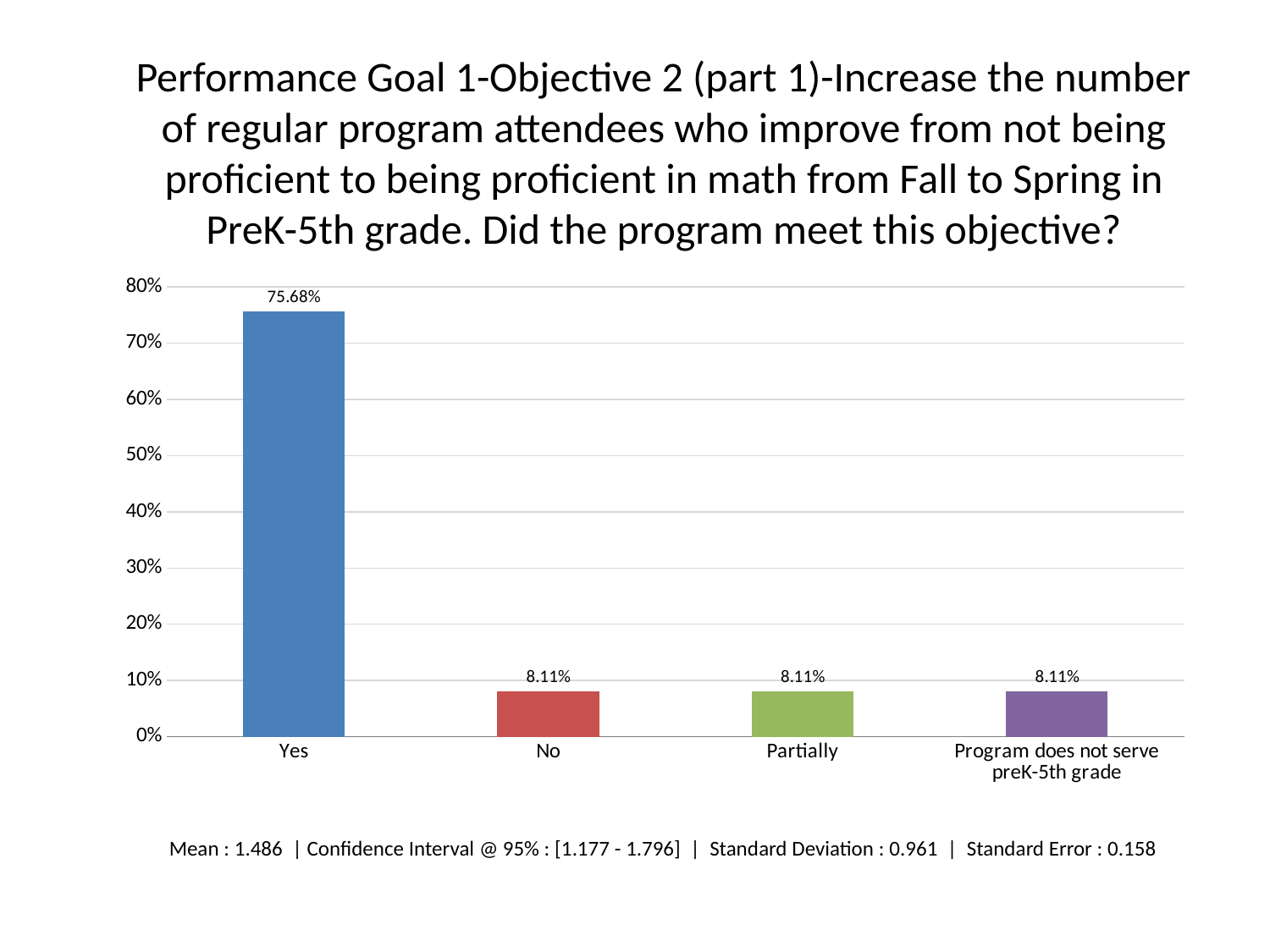
Which is larger, the value for Yes or the value for Partially? Yes Which category has the highest value? Yes What is the value for No? 8.11% What is the value for Yes? 75.68% What is the value for Partially? 8.11% Is the value for Yes greater or less than 70%? greater What is the value for 'Program does not serve preK-5th grade'? 8.11% What is the difference between the values for Yes and No? 67.57% What kind of chart is shown on the slide? bar chart How many categories are shown on the x axis? 4 Is the value for No greater or less than 10%? less What is the mean reported below the chart? 1.486